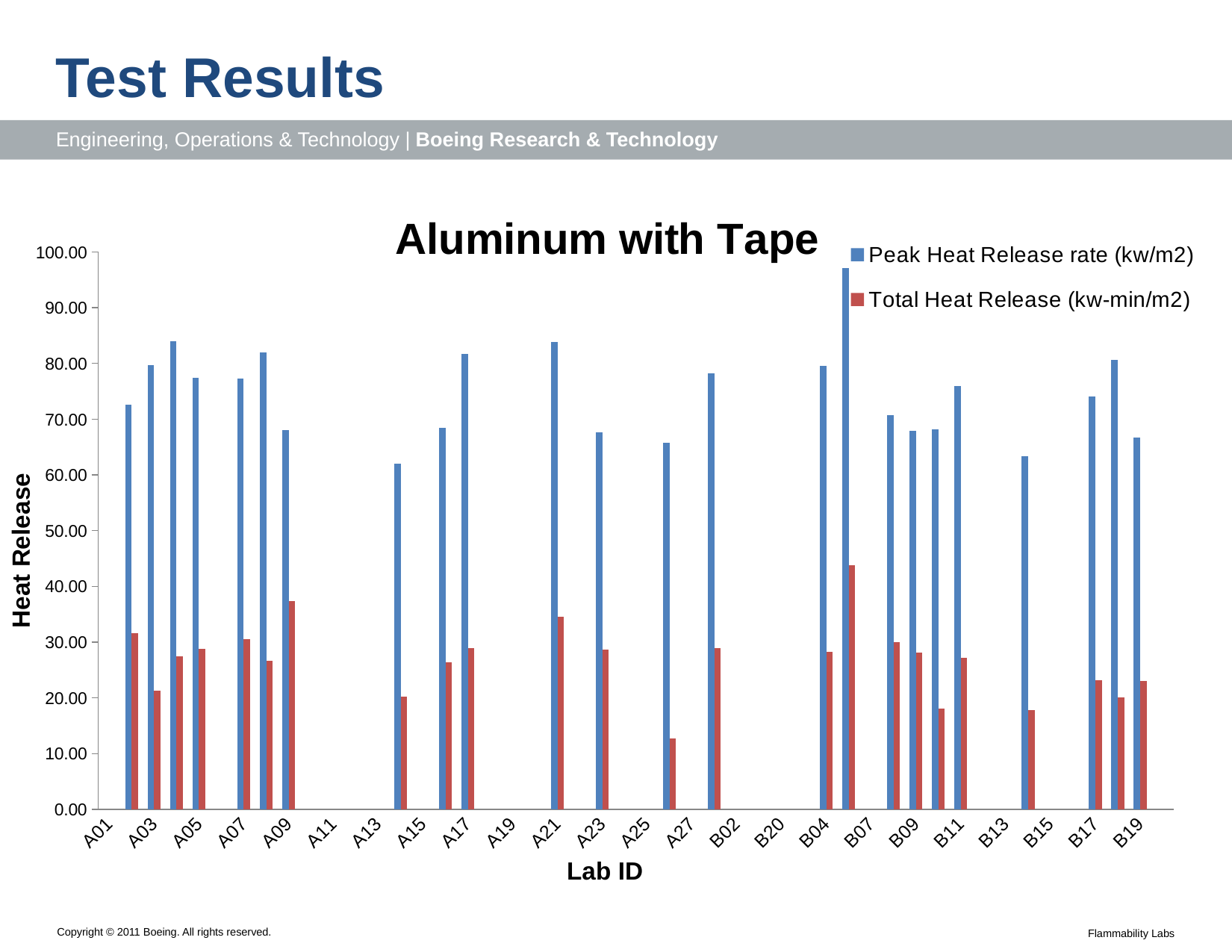
Is the Peak Heat Release rate value for A21 greater or less than 80? greater Which has the higher Peak Heat Release rate, A21 or A23? A21 What type of chart is shown on the slide? Bar chart Which series is shown in blue in the chart? Peak Heat Release rate (kw/m2) Is the Total Heat Release value for A21 greater or less than 30? greater How many category labels are printed along the x axis? 24 What is the title of the chart? Aluminum with Tape How many series does the legend list? 2 What is the label on the x axis of the chart? Lab ID Is the Peak Heat Release rate value for A03 greater or less than 70? greater